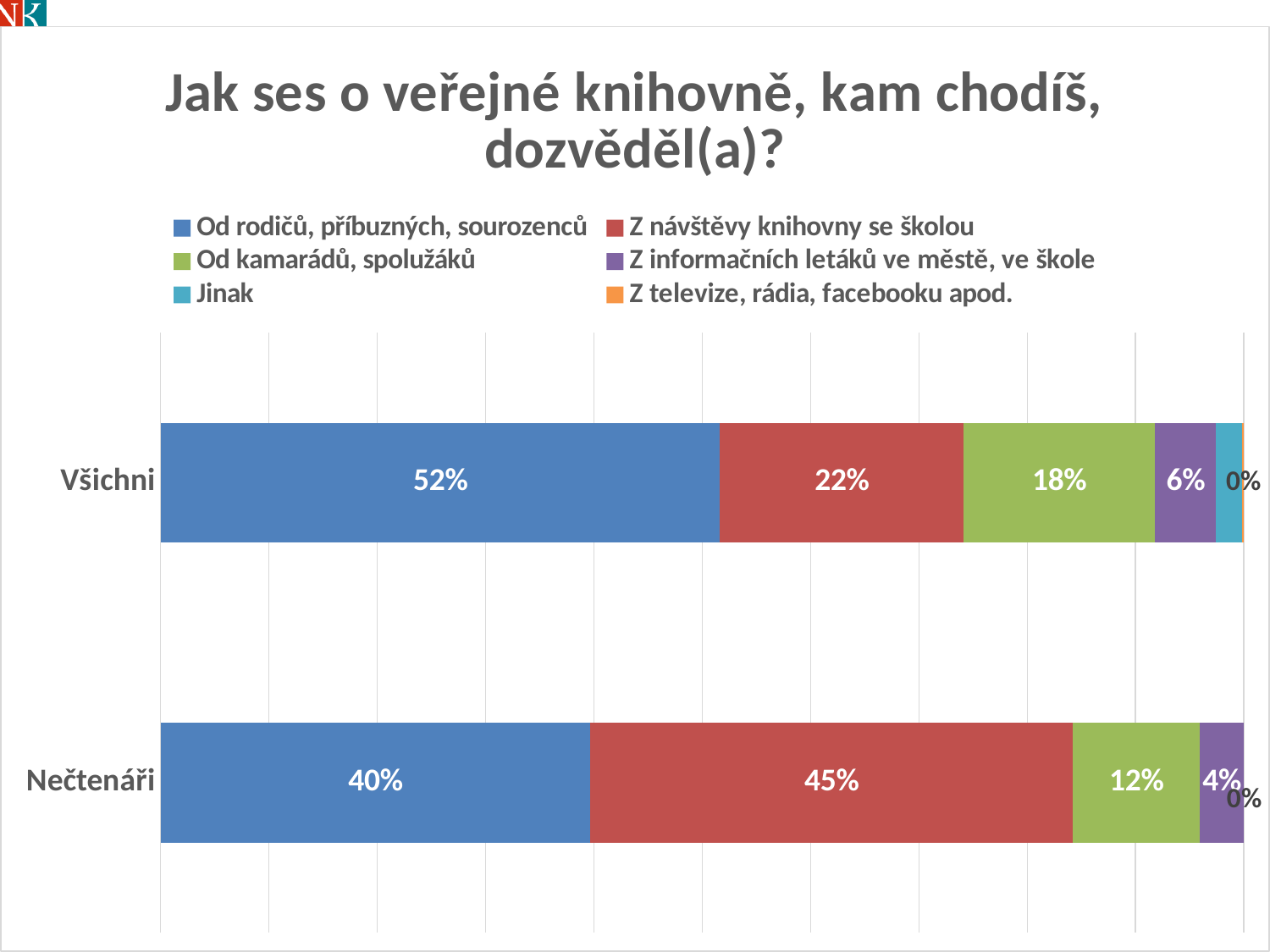
What is the value for 'Od rodičů, příbuzných, sourozenců' in the Všichni bar? 52% What is the value for 'Z informačních letáků ve městě, ve škole' in the Nečtenáři bar? 4% What is the difference between the 'Z návštěvy knihovny se školou' values for Nečtenáři and Všichni? 23% What is the value for 'Od kamarádů, spolužáků' in the Všichni bar? 18% What is the value for 'Z návštěvy knihovny se školou' in the Nečtenáři bar? 45% How many series does the legend list? 6 Which is larger: 'Od kamarádů, spolužáků' for Všichni or for Nečtenáři? Všichni Which series has the largest segment in the Nečtenáři bar? Z návštěvy knihovny se školou What colour represents 'Z návštěvy knihovny se školou' in the chart? red What kind of chart is shown on the slide? stacked bar chart How many categories (bars) are shown on the chart? 2 Which series has the largest segment in the Všichni bar? Od rodičů, příbuzných, sourozenců